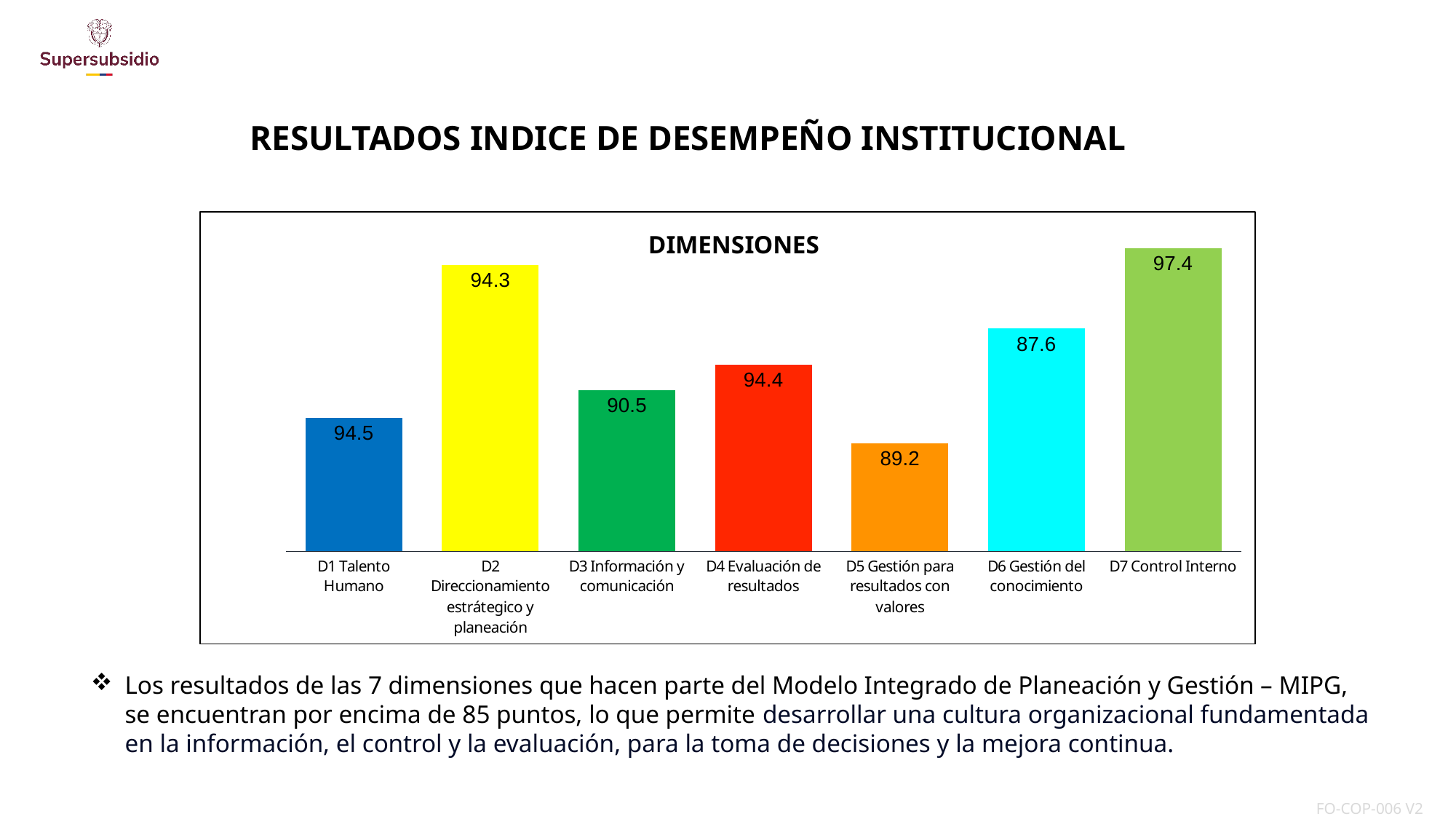
What is the difference between the values for D4 Evaluación de resultados and D5 Gestión para resultados con valores? 5.2 What is the value for D7 Control Interno? 97.4 What kind of chart is shown on the slide? Bar chart What is the title of the chart? DIMENSIONES How many dimensions are shown in the chart? 7 What is the difference between the values for D7 Control Interno and D6 Gestión del conocimiento? 9.8 What is the value for D3 Información y comunicación? 90.5 What is the value for D5 Gestión para resultados con valores? 89.2 Which dimension has the highest value? D7 Control Interno Which is larger, the value for D3 Información y comunicación or D5 Gestión para resultados con valores? D3 Información y comunicación What is the value for D6 Gestión del conocimiento? 87.6 Which is larger, the value for D6 Gestión del conocimiento or D7 Control Interno? D7 Control Interno